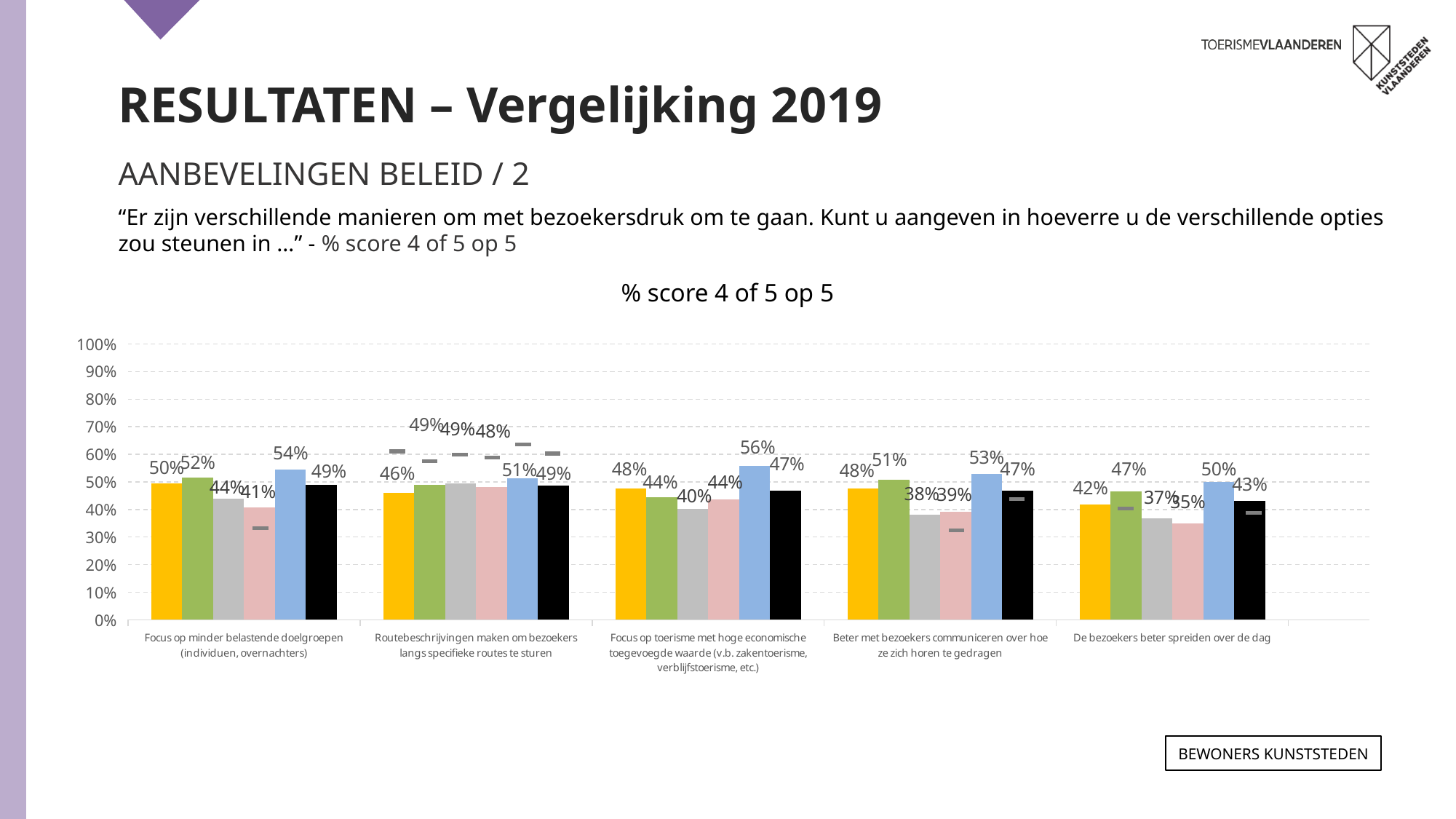
What is the value of the green bar for 'Routebeschrijvingen maken om bezoekers langs specifieke routes te sturen'? 49% Is the yellow bar higher for 'Focus op minder belastende doelgroepen' or for 'Routebeschrijvingen maken om bezoekers langs specifieke routes te sturen'? Focus op minder belastende doelgroepen For which category does the blue bar reach its highest value? Focus op toerisme met hoge economische toegevoegde waarde What kind of chart is shown on the slide? Bar chart Is the value of the blue bar for 'Beter met bezoekers communiceren over hoe ze zich horen te gedragen' greater or less than 50%? greater In the 'Focus op minder belastende doelgroepen' group, what is the difference between the blue bar (54%) and the pink bar (41%)? 13 percentage points What is the title of the chart? % score 4 of 5 op 5 What is the value of the yellow bar for 'Beter met bezoekers communiceren over hoe ze zich horen te gedragen'? 48% What is the lowest labelled value in the 'De bezoekers beter spreiden over de dag' group? 35% What is the value of the black bar for 'De bezoekers beter spreiden over de dag'? 43% What is the value of the blue bar for 'Focus op toerisme met hoge economische toegevoegde waarde'? 56% How many categories (policy options) are shown along the x axis of the chart? 5